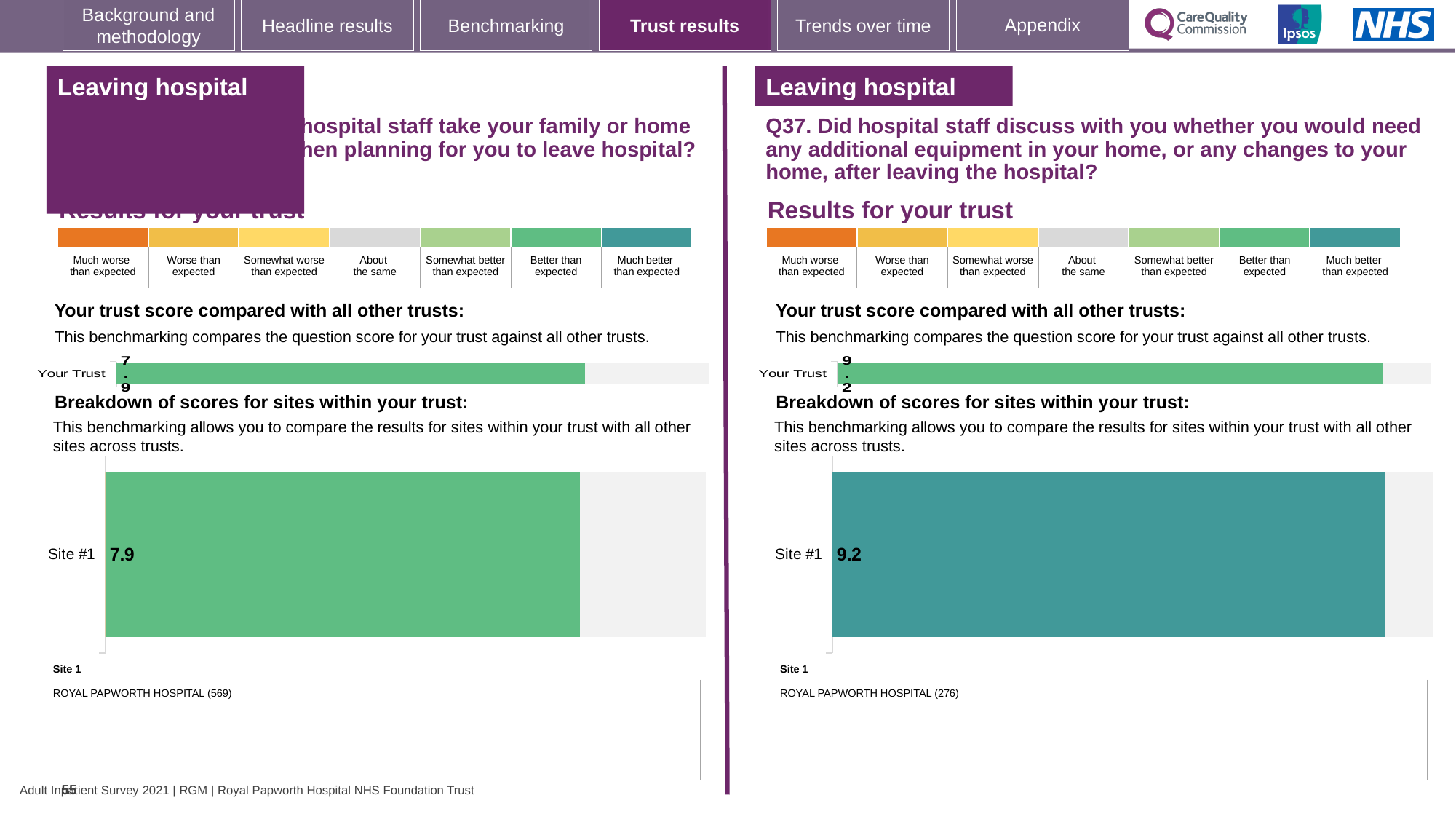
Which Site #1 score is larger: the one in the left-hand breakdown chart or the one in the right-hand (Q37) breakdown chart? The right-hand (Q37) chart What is the name of the site labelled Site 1 on the left half of the slide? ROYAL PAPWORTH HOSPITAL (569) On the left half of the slide, what is the score shown for Site #1 in the 'Breakdown of scores for sites within your trust' chart? 7.9 Is the Site #1 score in the right-hand (Q37) breakdown chart greater or less than 9? greater On the right half of the slide (Q37), what value is shown for 'Your Trust' in the 'Your trust score compared with all other trusts' chart? 9.2 What is the difference between the Site #1 score in the right-hand (Q37) breakdown chart and the Site #1 score in the left-hand breakdown chart? 1.3 How many sites are plotted in the left-hand 'Breakdown of scores for sites within your trust' chart? 1 What kind of chart is used for the Site #1 breakdown on the right half of the slide (Q37)? Bar chart On the right half of the slide (Q37), what is the score shown for Site #1 in the 'Breakdown of scores for sites within your trust' chart? 9.2 What is the name of the site labelled Site 1 on the right half of the slide (Q37)? ROYAL PAPWORTH HOSPITAL (276) On the left half of the slide, what value is shown for 'Your Trust' in the 'Your trust score compared with all other trusts' chart? 7.9 How many sites are plotted in the right-hand (Q37) 'Breakdown of scores for sites within your trust' chart? 1